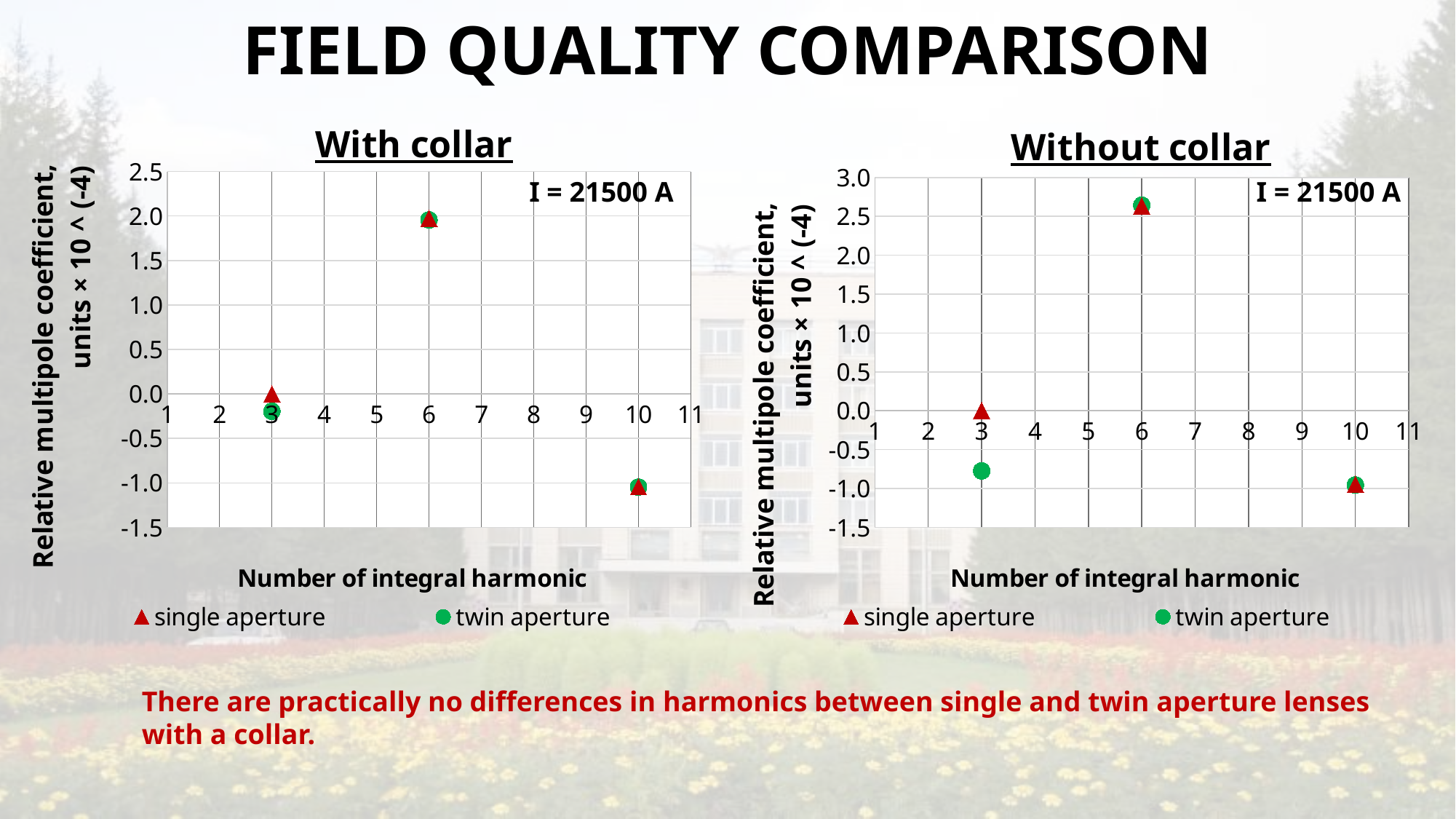
In the 'With collar' chart, what is the x-axis title? Number of integral harmonic In the 'Without collar' chart, is the twin aperture value at harmonic 6 greater or less than 2.5? greater In the 'With collar' chart, is the twin aperture value at harmonic 6 greater or less than 1.5? greater In the 'With collar' chart, how many harmonic numbers have plotted points? 3 In the 'With collar' chart, is the single aperture value at harmonic 10 greater or less than -0.5? less In the 'Without collar' chart, at which harmonic number is the single aperture value lowest? 10 In the 'With collar' chart, at which harmonic number is the twin aperture value highest? 6 In the 'Without collar' chart, what current value is annotated on the plot? I = 21500 A In the 'Without collar' chart, at harmonic 3, which series has the larger value: single aperture or twin aperture? single aperture In the 'With collar' chart, what kind of chart is shown? scatter chart In the 'Without collar' chart, how many series does the legend list? 2